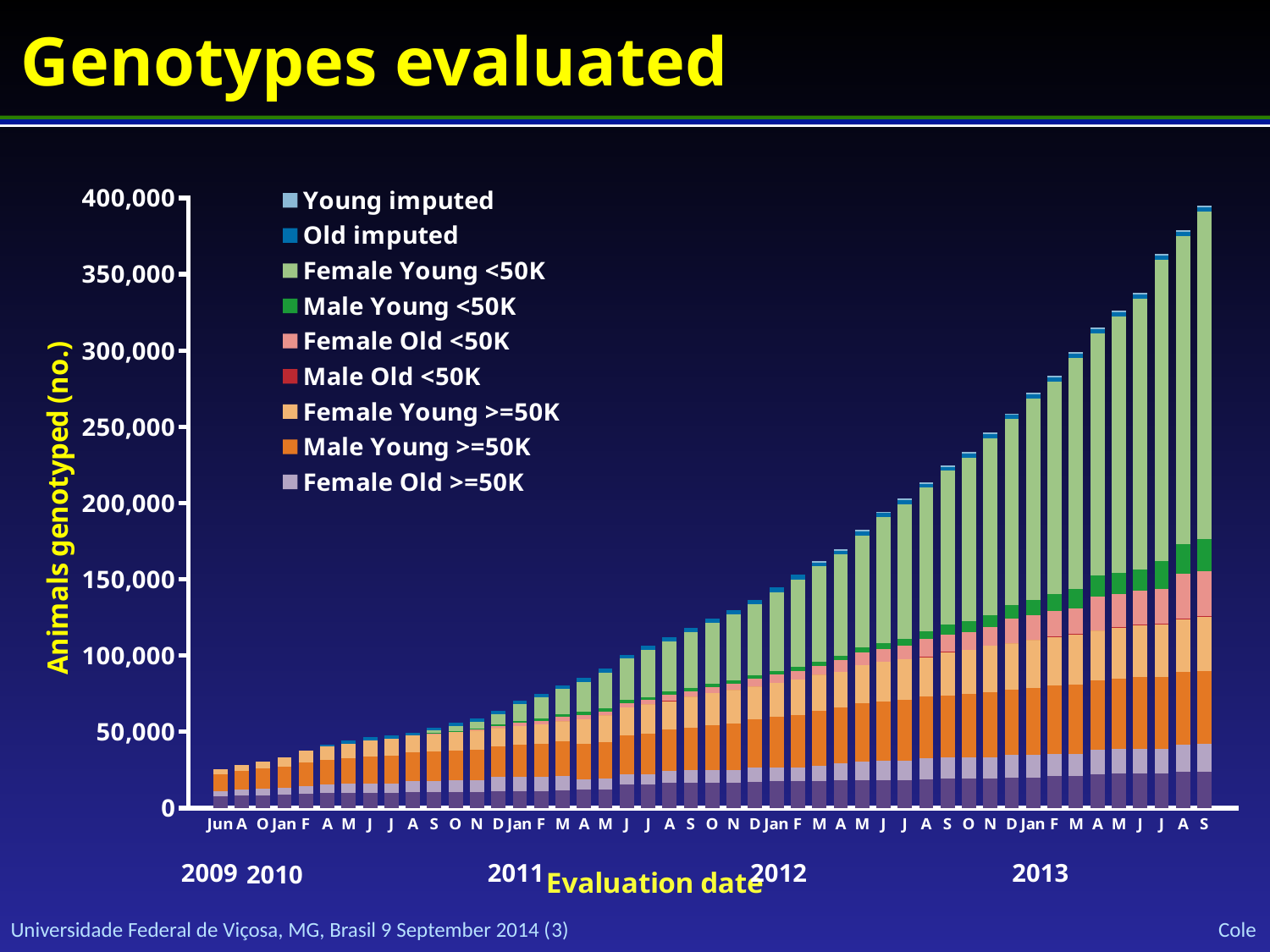
Is the total for Jun 2009 greater or less than 50,000? less What is the label of the x axis? Evaluation date Is the total for the last bar (S 2013) greater or less than 350,000? greater Which has a larger total of animals genotyped, Jan 2012 or Jan 2013? Jan 2013 What kind of chart is shown on the slide? Stacked bar chart What is the label of the y axis? Animals genotyped (no.) How many series does the legend list? 9 Is the total for Jan 2013 greater or less than 200,000? greater Which evaluation date has the lowest total of animals genotyped? Jun 2009 Do the total animals genotyped rise or fall along the x axis from 2009 to 2013? Rise Which evaluation date has the highest total of animals genotyped? S 2013 (September 2013)